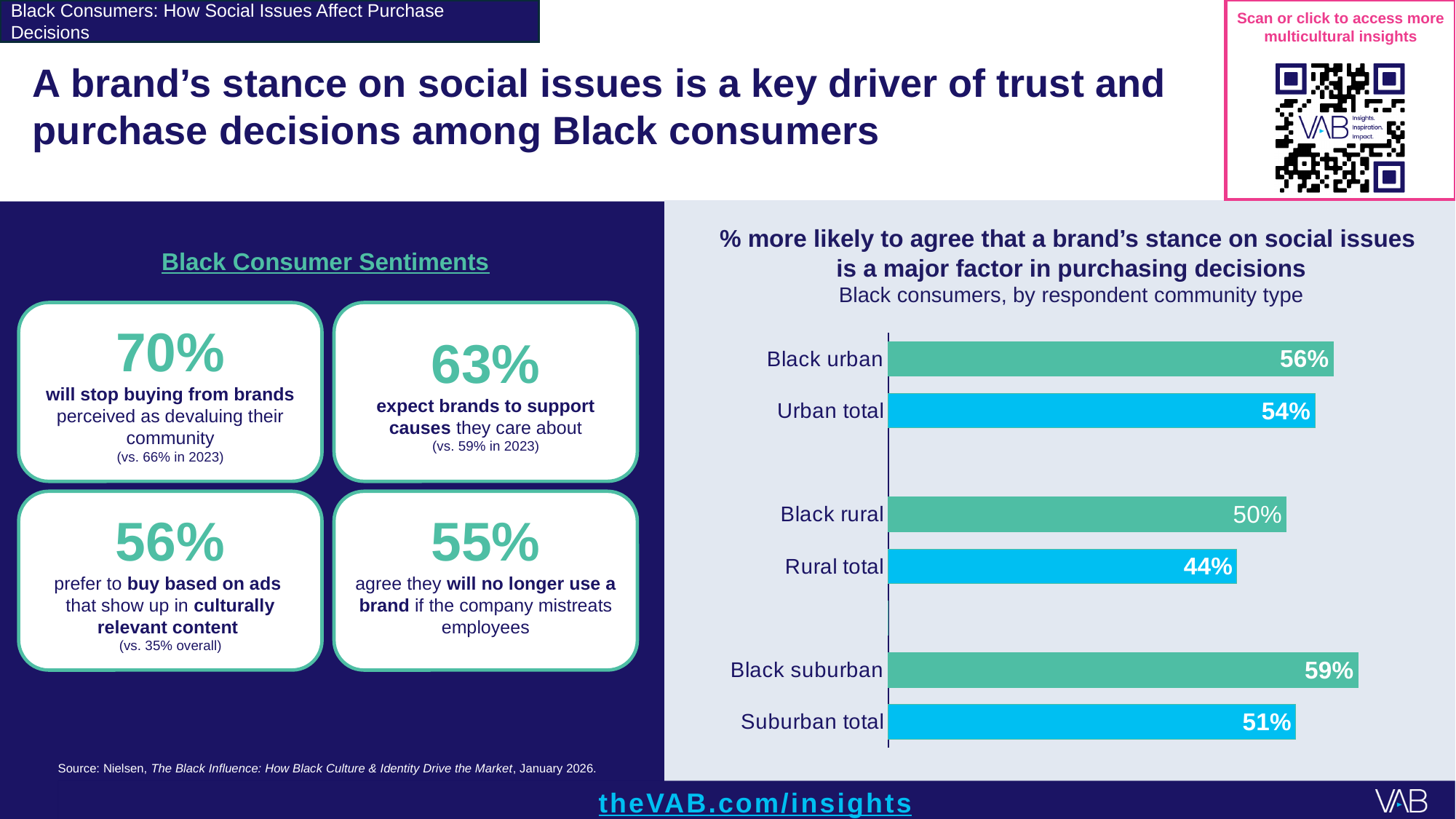
What is the difference between Black rural and Rural total? 6% Which category has the highest value? Black suburban What is the subtitle of the chart, below the main title? Black consumers, by respondent community type Which is larger, Black urban or Urban total? Black urban What is the value for Suburban total? 51% What is the difference between Black suburban and Suburban total? 8% What kind of chart is shown? Bar chart What is the value for Rural total? 44% What is the value for Black urban? 56% How many bars are shown in the chart? 6 Which category has the lowest value? Rural total What is the value for Black suburban? 59%